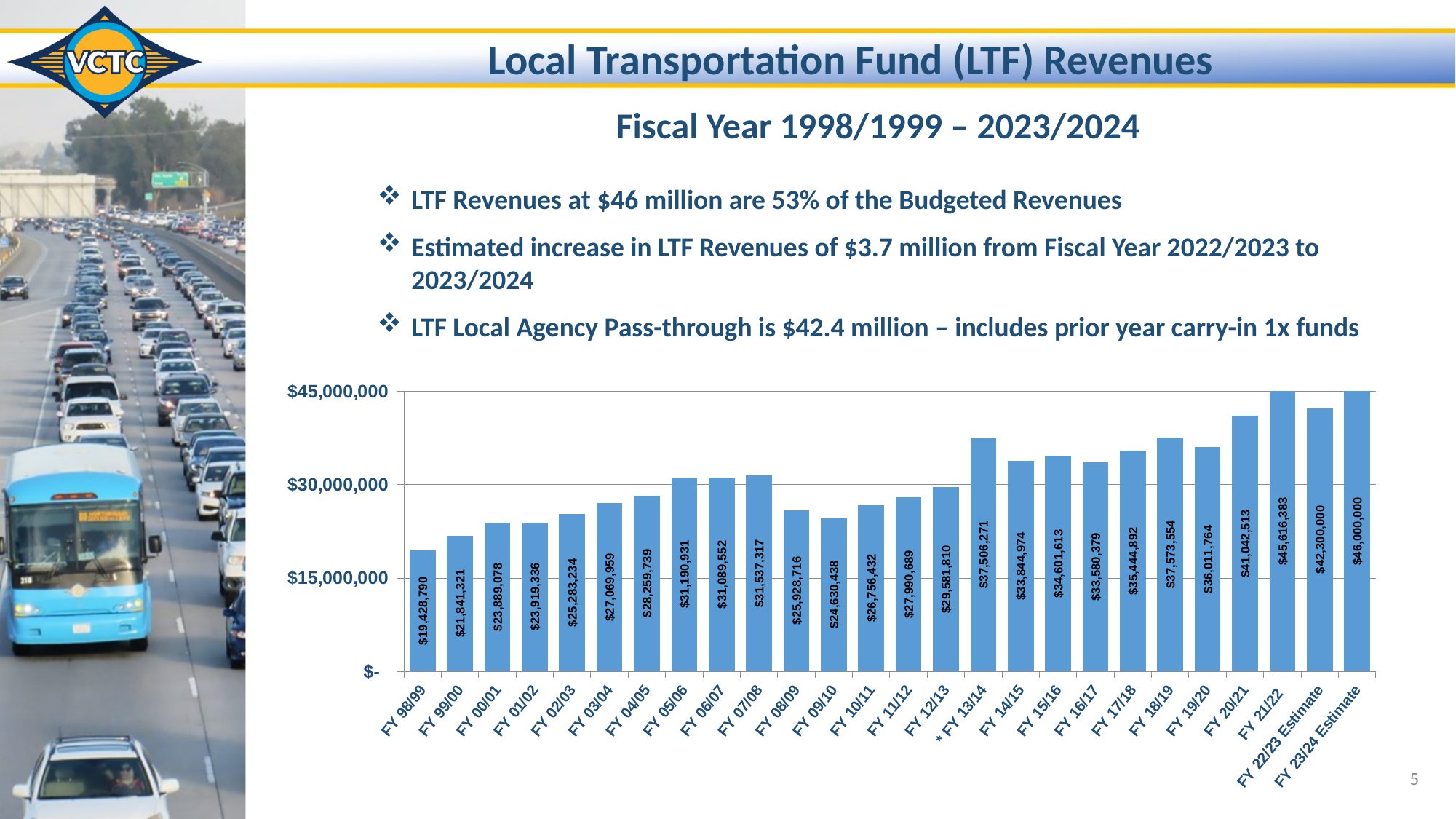
What is the difference between the FY 21/22 and FY 20/21 values? $4,573,870 Which fiscal year has the highest LTF revenue in the chart? FY 23/24 Estimate Is the value for FY 09/10 greater or less than $30,000,000? less Which fiscal year has the lowest LTF revenue in the chart? FY 98/99 What is the LTF revenue value for FY 13/14? $37,506,271 Do the values generally rise or fall from FY 08/09 to FY 12/13? rise How many fiscal years are plotted in the chart? 26 What is the LTF revenue value for FY 22/23 Estimate? $42,300,000 Which is larger, the value for FY 05/06 or FY 06/07? FY 05/06 What is the difference between the FY 23/24 Estimate and the FY 22/23 Estimate values? $3,700,000 What kind of chart is shown on the slide? bar chart What is the LTF revenue value for FY 98/99? $19,428,790